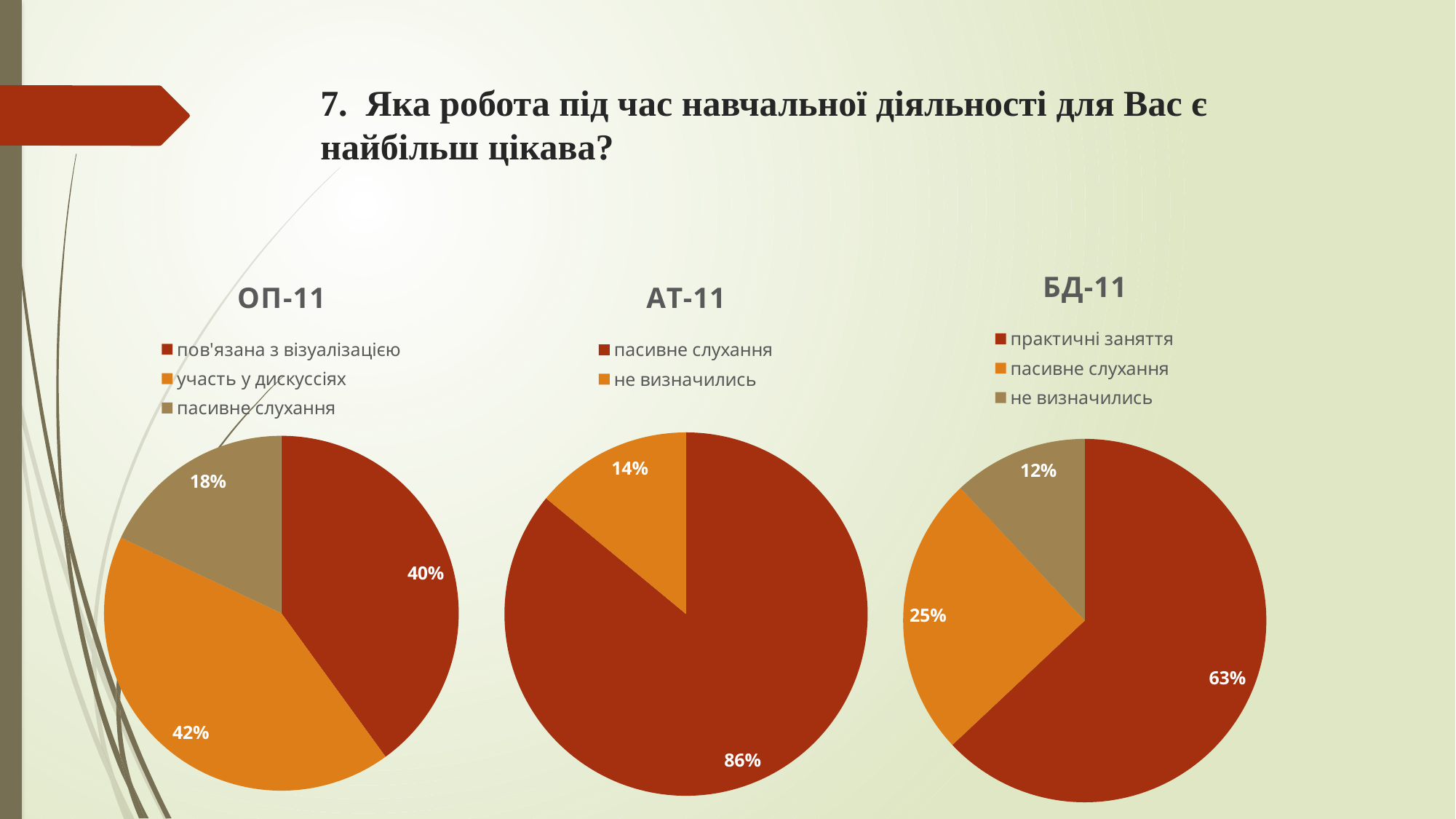
In the АТ-11 chart, how many entries does the legend list? 2 What kind of charts are shown on the slide? Pie charts In the АТ-11 chart, what share is labelled for пасивне слухання? 86% In the БД-11 chart, which category has the largest slice? практичні заняття In the ОП-11 chart, what share is labelled for участь у дискуссіях? 42% In the ОП-11 chart, which category has the smallest slice? пасивне слухання In the ОП-11 chart, what share is labelled for пов'язана з візуалізацією? 40% In the ОП-11 chart, how many slices does the pie have? 3 In the БД-11 chart, which is larger: пасивне слухання or не визначились? пасивне слухання In the АТ-11 chart, what is the difference between the пасивне слухання slice and the не визначились slice? 72% In the БД-11 chart, what share is labelled for практичні заняття? 63% What is the title of the chart on the right of the slide? БД-11